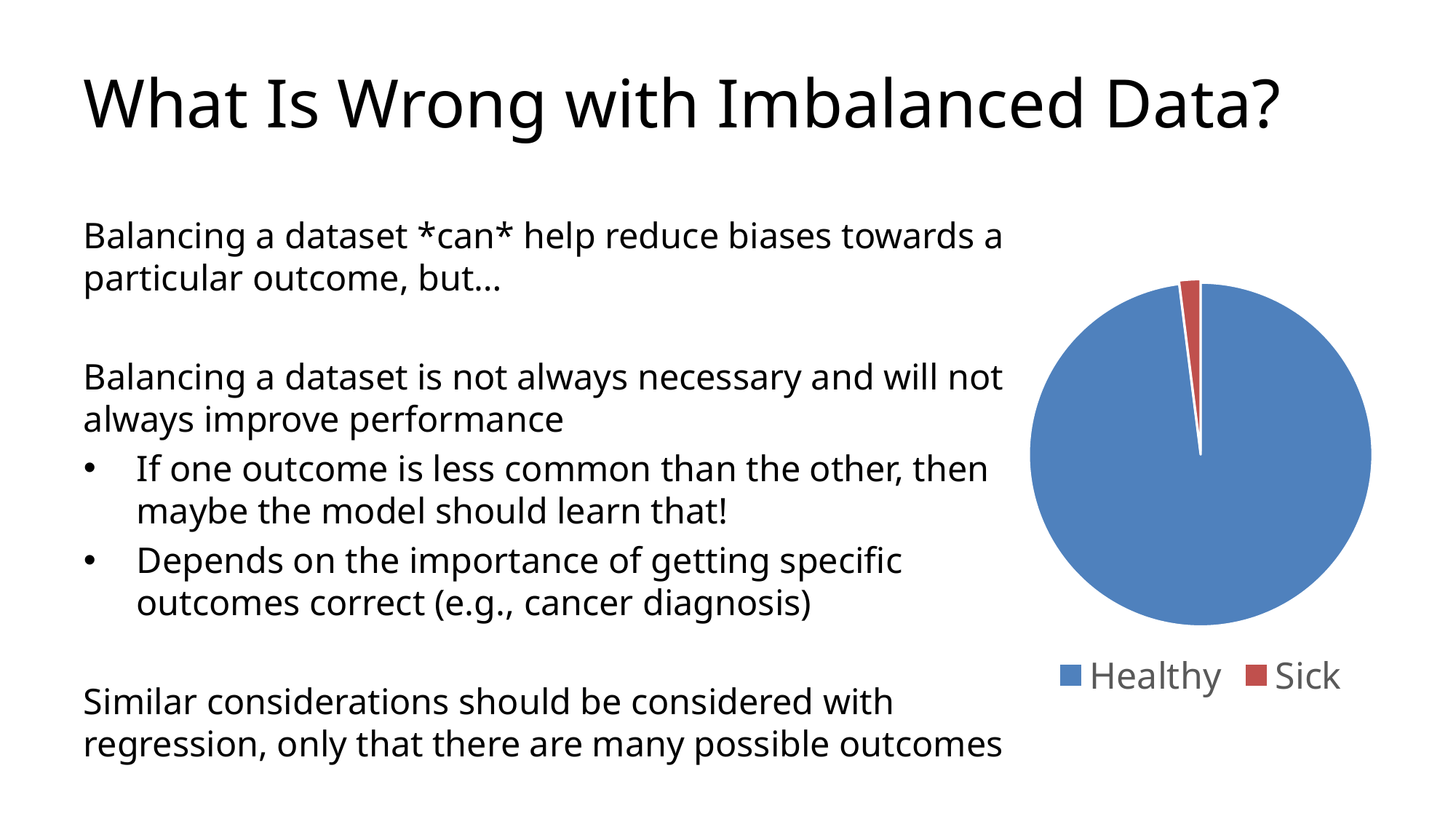
Which slice is larger in the pie chart, Healthy or Sick? Healthy What colour is the Healthy slice in the pie chart? blue How many entries does the pie chart's legend list? 2 Which category has the largest slice in the pie chart? Healthy How many categories does the pie chart show? 2 Which category has the smallest slice in the pie chart? Sick What kind of chart is shown on the slide? pie chart What colour is the Sick slice in the pie chart? red